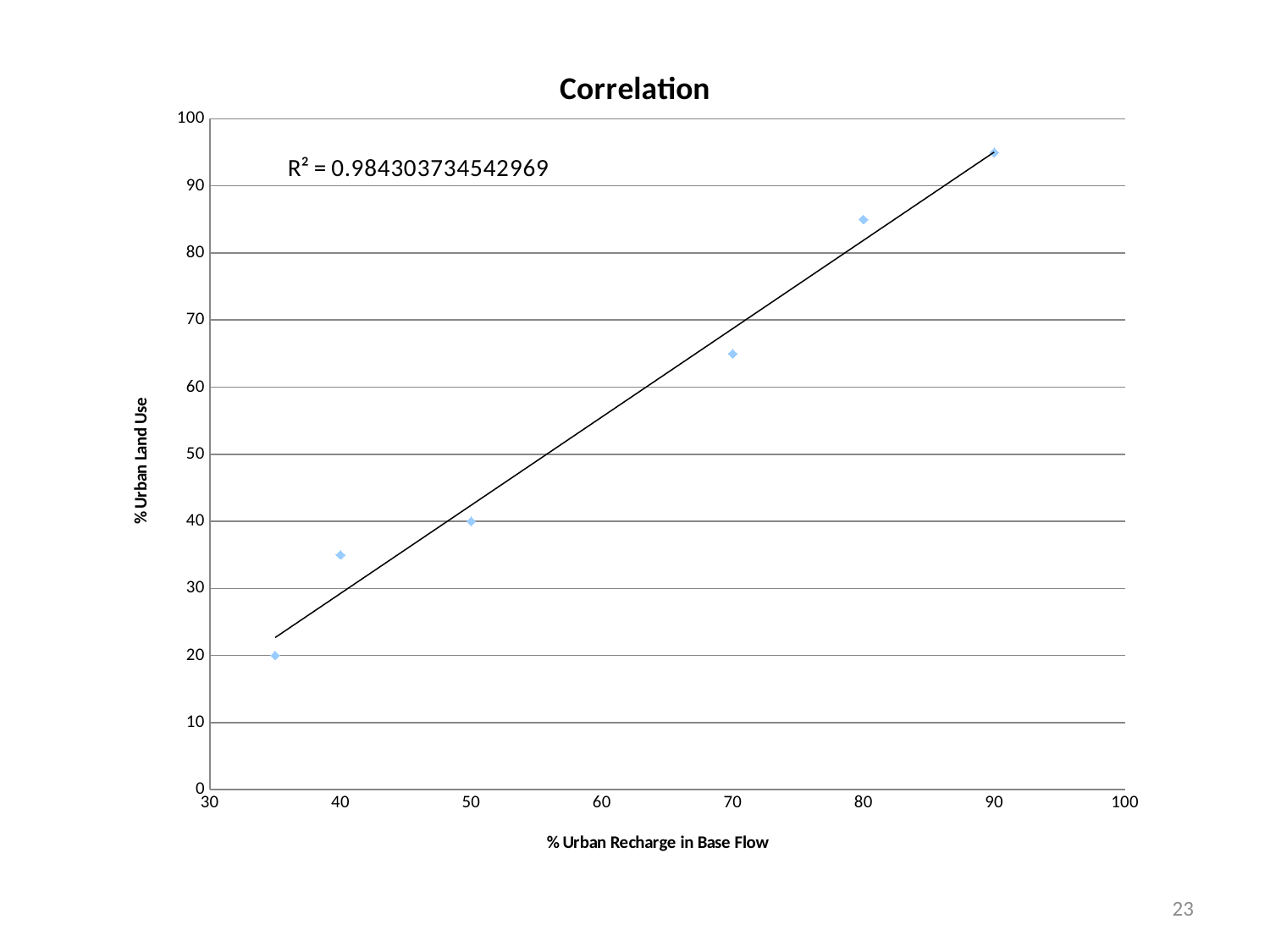
What is the R² value printed on the chart? 0.984303734542969 At which % Urban Recharge in Base Flow value does the point with the highest % Urban Land Use occur? 90 What is the label of the x axis? % Urban Recharge in Base Flow Is the % Urban Land Use value for the point at 80 % Urban Recharge in Base Flow greater or less than 90? less What is the % Urban Land Use value for the point at 50 % Urban Recharge in Base Flow? 40 Which point has the highest % Urban Land Use: the one at 80 or the one at 90 % Urban Recharge in Base Flow? 90 What kind of chart is shown on the slide? scatter chart Is the % Urban Land Use value for the point at 70 % Urban Recharge in Base Flow greater or less than 60? greater How many data points are plotted on the chart? 6 Is the % Urban Land Use value for the point at 40 % Urban Recharge in Base Flow greater or less than 30? greater What is the title of the chart? Correlation Do the % Urban Land Use values rise or fall as % Urban Recharge in Base Flow increases? rise